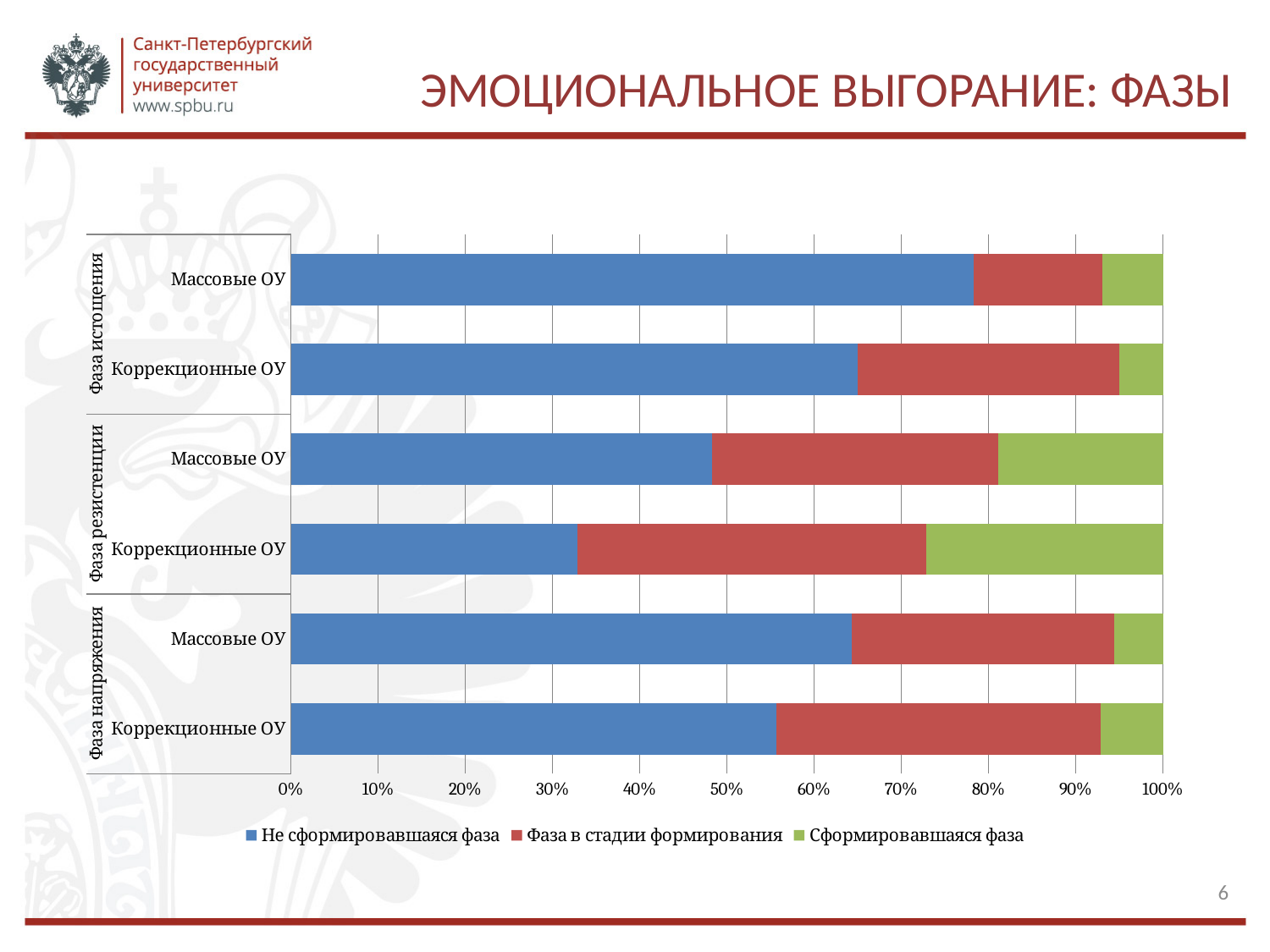
Which series is shown in blue according to the legend? Не сформировавшаяся фаза What is the title of the slide containing the chart? ЭМОЦИОНАЛЬНОЕ ВЫГОРАНИЕ: ФАЗЫ Which bar has the largest share of 'Сформировавшаяся фаза'? Коррекционные ОУ, Фаза резистенции How many series does the legend list? 3 Is the share of 'Не сформировавшаяся фаза' for Коррекционные ОУ in Фаза напряжения greater or less than 50%? greater What kind of chart is shown on the slide? Stacked bar chart In Фаза резистенции, which group has the larger share of 'Не сформировавшаяся фаза': Массовые ОУ or Коррекционные ОУ? Массовые ОУ Is the share of 'Не сформировавшаяся фаза' for Массовые ОУ in Фаза истощения greater or less than 70%? greater Is the share of 'Не сформировавшаяся фаза' for Массовые ОУ in Фаза резистенции greater or less than 60%? less Which bar has the largest share of 'Не сформировавшаяся фаза'? Массовые ОУ, Фаза истощения How many bars are plotted in the chart? 6